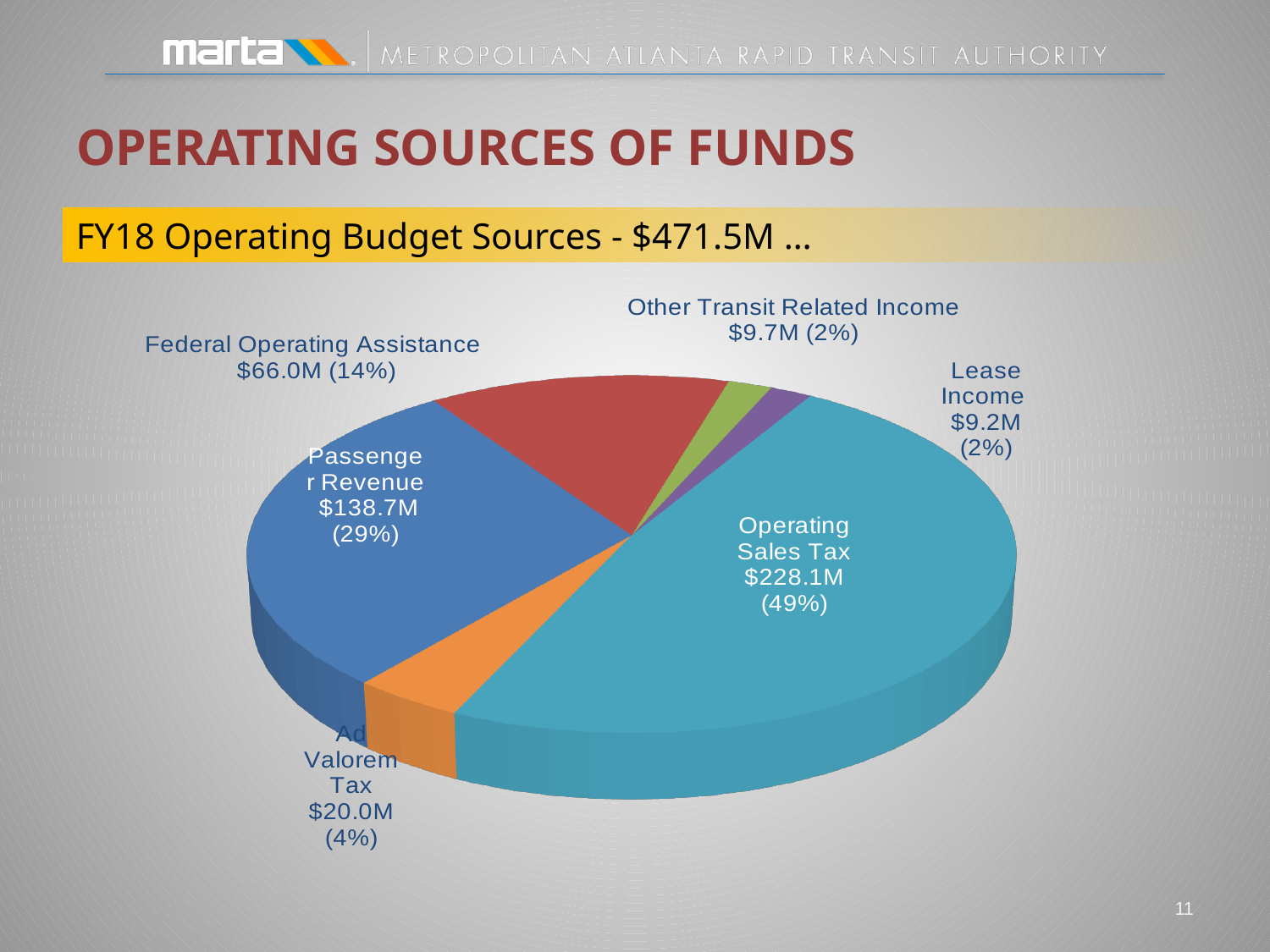
What is the value for Passenger Revenue? $138.7M Which is larger, Federal Operating Assistance or Ad Valorem Tax? Federal Operating Assistance Which category has the smallest slice? Lease Income Which category has the largest slice? Operating Sales Tax What is the value for Ad Valorem Tax? $20.0M What is the difference between Operating Sales Tax and Passenger Revenue? $89.4M How many slices does the pie chart have? 6 What is the value for Federal Operating Assistance? $66.0M What share of the pie does Operating Sales Tax represent? 49% What share of the pie does Lease Income represent? 2% What kind of chart is shown on the slide? Pie chart What is the value for Operating Sales Tax? $228.1M